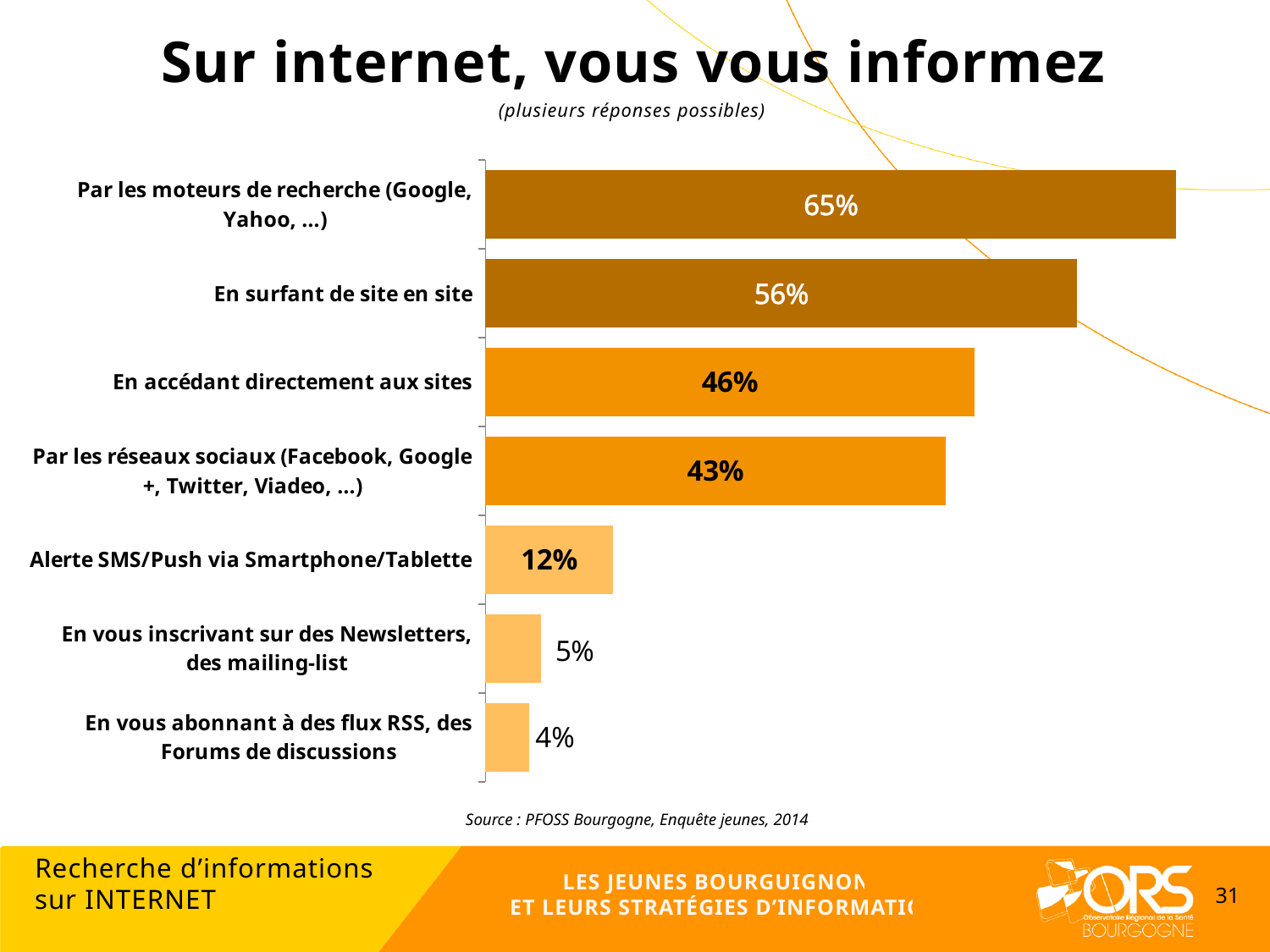
Which category has the highest value? Par les moteurs de recherche (Google, Yahoo, …) Which category has the lowest value? En vous abonnant à des flux RSS, des Forums de discussions What percentage of respondents get information via search engines (Par les moteurs de recherche)? 65% What is the difference between 'Par les moteurs de recherche' and 'En surfant de site en site'? 9 percentage points Which is larger: 'Alerte SMS/Push via Smartphone/Tablette' or 'En vous inscrivant sur des Newsletters, des mailing-list'? Alerte SMS/Push via Smartphone/Tablette What is the source cited below the chart? PFOSS Bourgogne, Enquête jeunes, 2014 What is the value for 'Alerte SMS/Push via Smartphone/Tablette'? 12% How many categories are shown in the chart? 7 What is the value for 'En surfant de site en site'? 56% What type of chart is shown on the slide? Bar chart What is the difference between 'En accédant directement aux sites' and 'Par les réseaux sociaux'? 3 percentage points What is the value for 'Par les réseaux sociaux (Facebook, Google +, Twitter, Viadeo, …)'? 43%